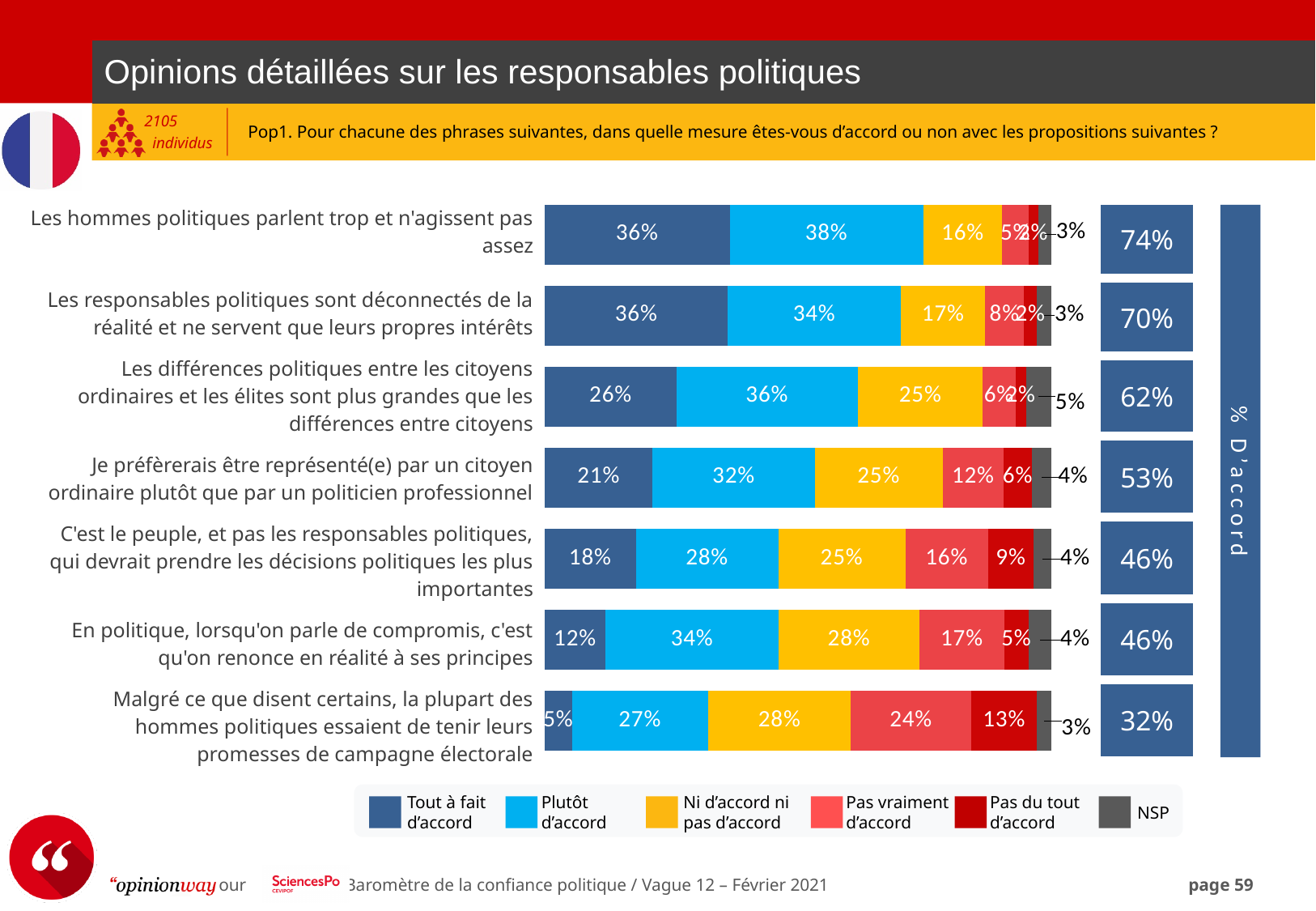
What kind of chart is shown on the slide? Stacked bar chart What is the 'Pas du tout d'accord' value for 'Malgré ce que disent certains, la plupart des hommes politiques essaient de tenir leurs promesses de campagne électorale'? 13% Which is larger: the 'Pas vraiment d'accord' value for 'C'est le peuple, et pas les responsables politiques, qui devrait prendre les décisions politiques les plus importantes' or for 'Je préfèrerais être représenté(e) par un citoyen ordinaire plutôt que par un politicien professionnel'? C'est le peuple, et pas les responsables politiques, qui devrait prendre les décisions politiques les plus importantes What is the '% D'accord' total shown for 'Je préfèrerais être représenté(e) par un citoyen ordinaire plutôt que par un politicien professionnel'? 53% Which statement has the highest '% D'accord' total? Les hommes politiques parlent trop et n'agissent pas assez How many series does the legend list? 6 What is the 'Tout à fait d'accord' value for 'Les hommes politiques parlent trop et n'agissent pas assez'? 36% What colour represents 'Ni d'accord ni pas d'accord' in the legend? Yellow How many statements (categories) are plotted in the chart? 7 What is the difference between the '% D'accord' totals for 'Les responsables politiques sont déconnectés de la réalité et ne servent que leurs propres intérêts' and 'Les différences politiques entre les citoyens ordinaires et les élites sont plus grandes que les différences entre citoyens'? 8 percentage points What is the 'Plutôt d'accord' value for 'En politique, lorsqu'on parle de compromis, c'est qu'on renonce en réalité à ses principes'? 34% Which statement has the lowest '% D'accord' total? Malgré ce que disent certains, la plupart des hommes politiques essaient de tenir leurs promesses de campagne électorale